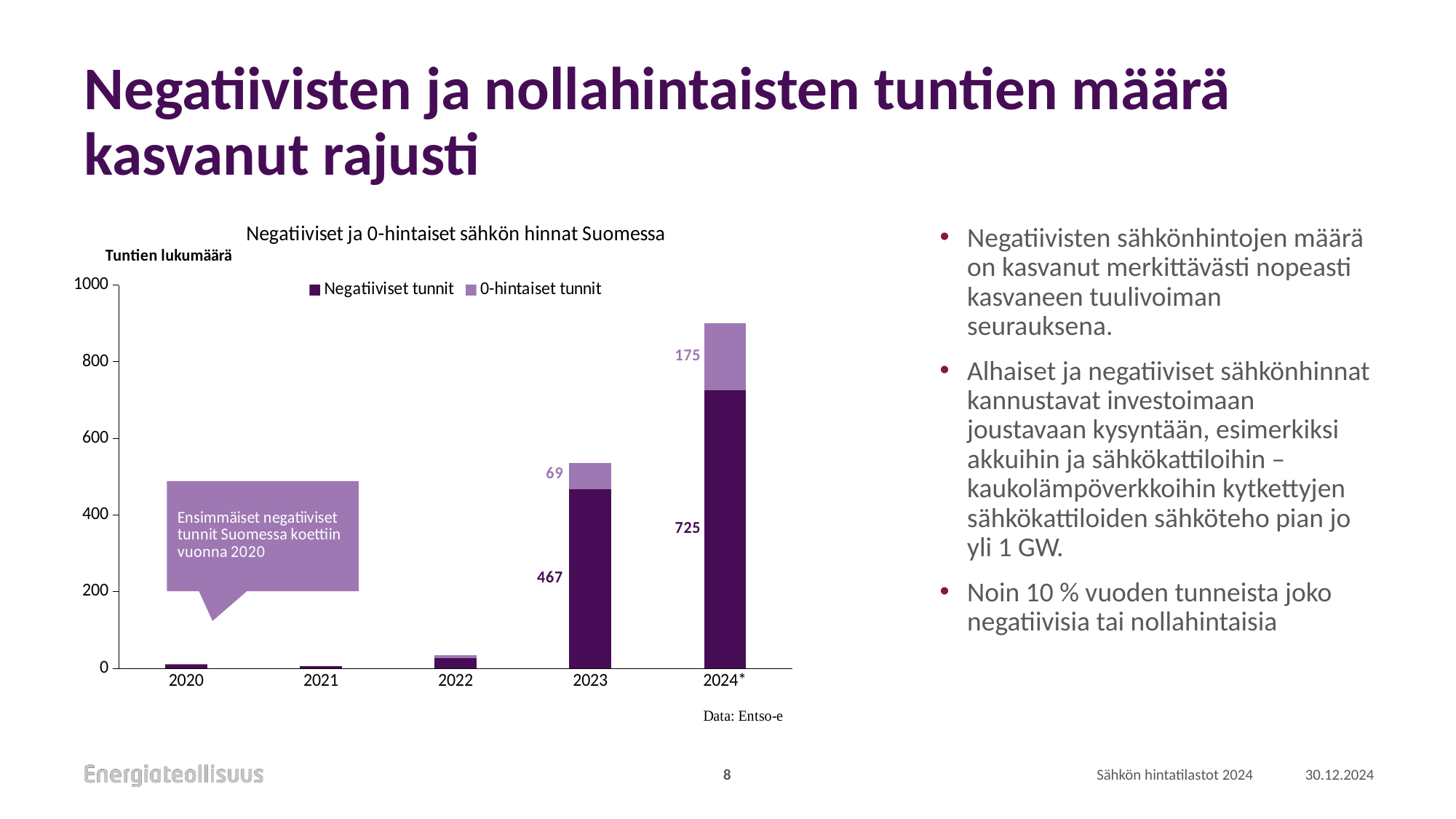
Which year has the highest total number of hours in the chart? 2024* Is the total value for 2023 greater or less than 400? greater What is the total height of the stacked bar for 2024*? 900 How many series does the chart legend list? 2 How many years are shown on the x axis of the chart? 5 What is the value of Negatiiviset tunnit for 2024*? 725 What is the title of the chart? Negatiiviset ja 0-hintaiset sähkön hinnat Suomessa What is the value of 0-hintaiset tunnit for 2024*? 175 What is the value of 0-hintaiset tunnit for 2023? 69 What is the value of Negatiiviset tunnit for 2023? 467 What is the difference between Negatiiviset tunnit in 2024* and in 2023? 258 What type of chart is shown on the slide? Stacked bar chart